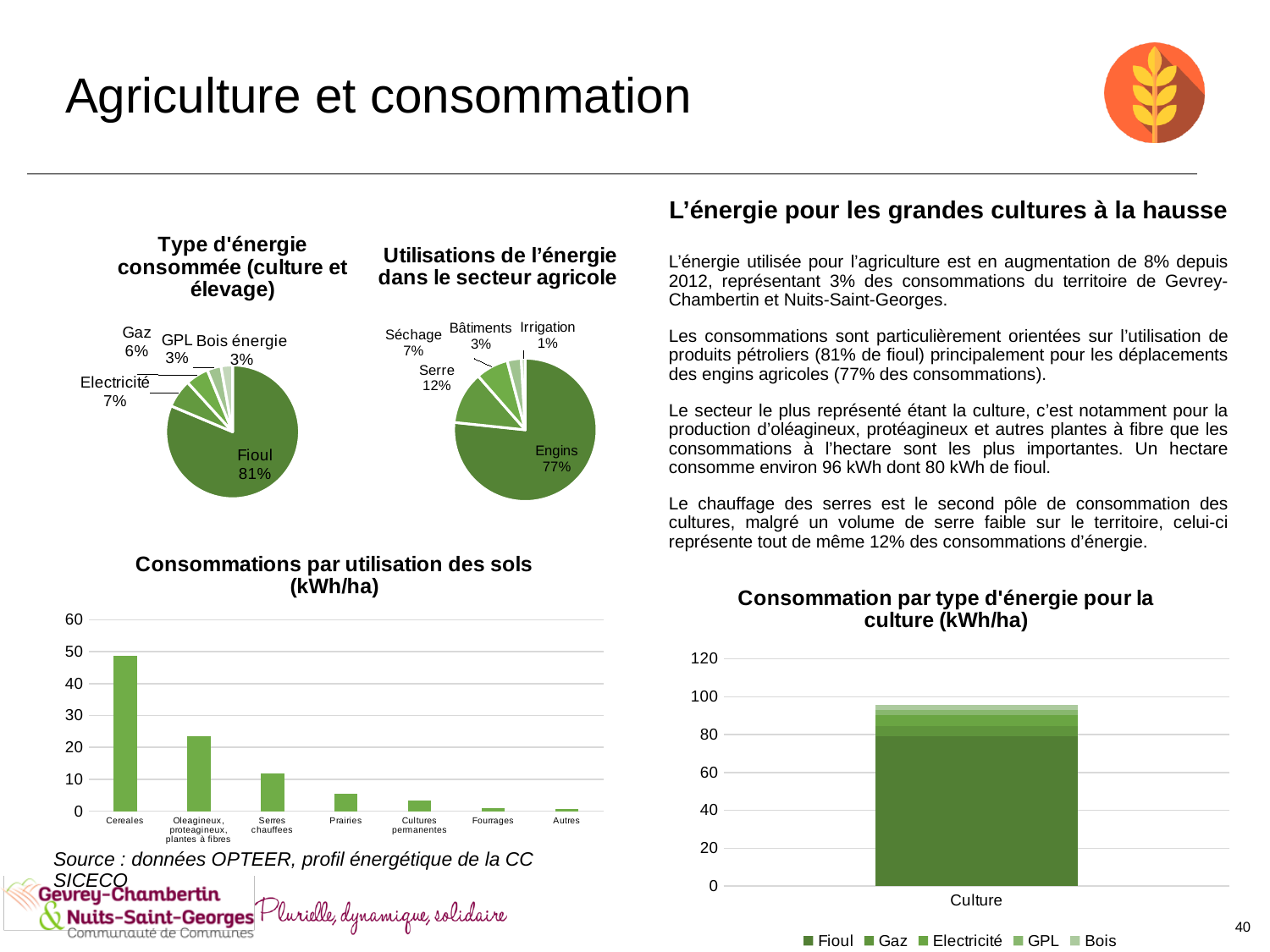
In the chart 'Consommations par utilisation des sols (kWh/ha)', which category has the highest value? Cereales In the chart 'Consommations par utilisation des sols (kWh/ha)', how many categories are shown on the x axis? 7 In the pie chart 'Utilisations de l'énergie dans le secteur agricole', which category has the smallest share? Irrigation How many series does the legend of the chart 'Consommation par type d'énergie pour la culture (kWh/ha)' list? 5 In the pie chart 'Type d'énergie consommée (culture et élevage)', what is the share of Electricité? 7% In the pie chart 'Utilisations de l'énergie dans le secteur agricole', which category has the largest share? Engins In the pie chart 'Utilisations de l'énergie dans le secteur agricole', which is larger, Séchage or Bâtiments? Séchage What kind of chart is 'Consommation par type d'énergie pour la culture (kWh/ha)'? Stacked bar chart In the pie chart 'Type d'énergie consommée (culture et élevage)', what share does Fioul represent? 81% In the pie chart 'Type d'énergie consommée (culture et élevage)', what is the difference between the shares of Gaz and GPL? 3% In the pie chart 'Utilisations de l'énergie dans le secteur agricole', what share does Serre represent? 12% In the chart 'Consommations par utilisation des sols (kWh/ha)', is the value for Cereales greater or less than 40? greater